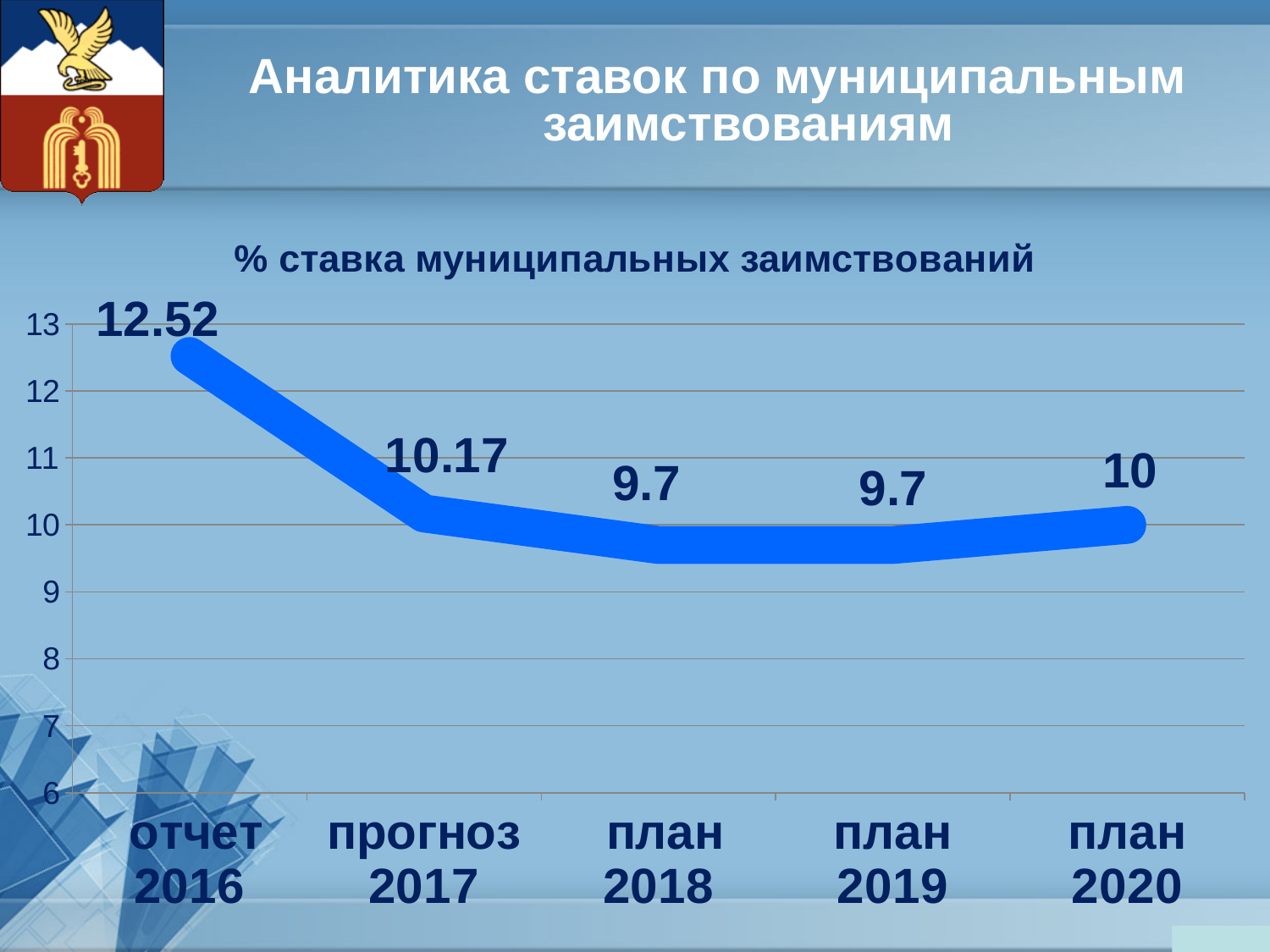
Is the value for план 2018 greater or less than 10? less What kind of chart is shown on the slide? line chart What is the lowest value shown on the chart? 9.7 What is the title of the chart? % ставка муниципальных заимствований Which category has the highest value? отчет 2016 What is the value for отчет 2016? 12.52 How many categories are shown on the x axis? 5 What is the difference between the values for отчет 2016 and прогноз 2017? 2.35 What is the value for прогноз 2017? 10.17 What is the difference between the values for план 2020 and план 2019? 0.3 Which is larger, the value for прогноз 2017 or the value for план 2018? прогноз 2017 What is the value for план 2020? 10